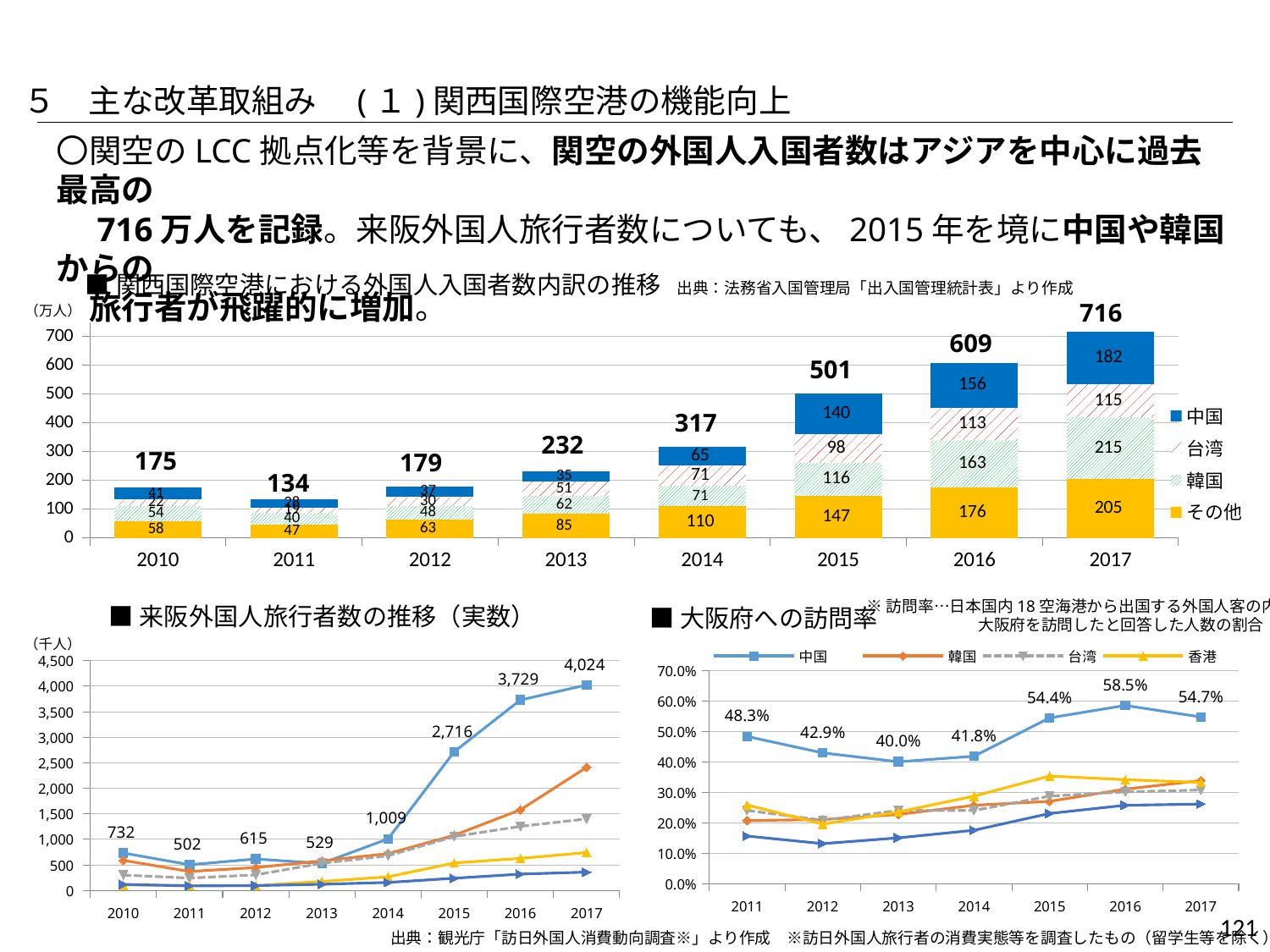
In the top chart (関西国際空港における外国人入国者数内訳の推移), what kind of chart is it? Stacked bar chart In the top chart (関西国際空港における外国人入国者数内訳の推移), how many series does the legend list? 4 In the top chart (関西国際空港における外国人入国者数内訳の推移), which year has the lowest total? 2011 In the top chart (関西国際空港における外国人入国者数内訳の推移), what is the total value shown for 2017? 716 In the bottom-left chart (来阪外国人旅行者数の推移（実数）), what is the value labelled for 2017 on the top line? 4,024 In the top chart (関西国際空港における外国人入国者数内訳の推移), what is the value for 中国 in 2015? 140 In the top chart (関西国際空港における外国人入国者数内訳の推移), what is the difference between the totals for 2017 and 2016? 107 In the bottom-right chart (大阪府への訪問率), in which year is the 中国 value lowest? 2013 In the bottom-right chart (大阪府への訪問率), what is the value for 中国 in 2016? 58.5% In the top chart (関西国際空港における外国人入国者数内訳の推移), which is larger in 2016: 中国 or 台湾? 中国 In the top chart (関西国際空港における外国人入国者数内訳の推移), what is the value for 韓国 in 2017? 215 In the bottom-left chart (来阪外国人旅行者数の推移（実数）), what is the value labelled for 2014 on the top line? 1,009